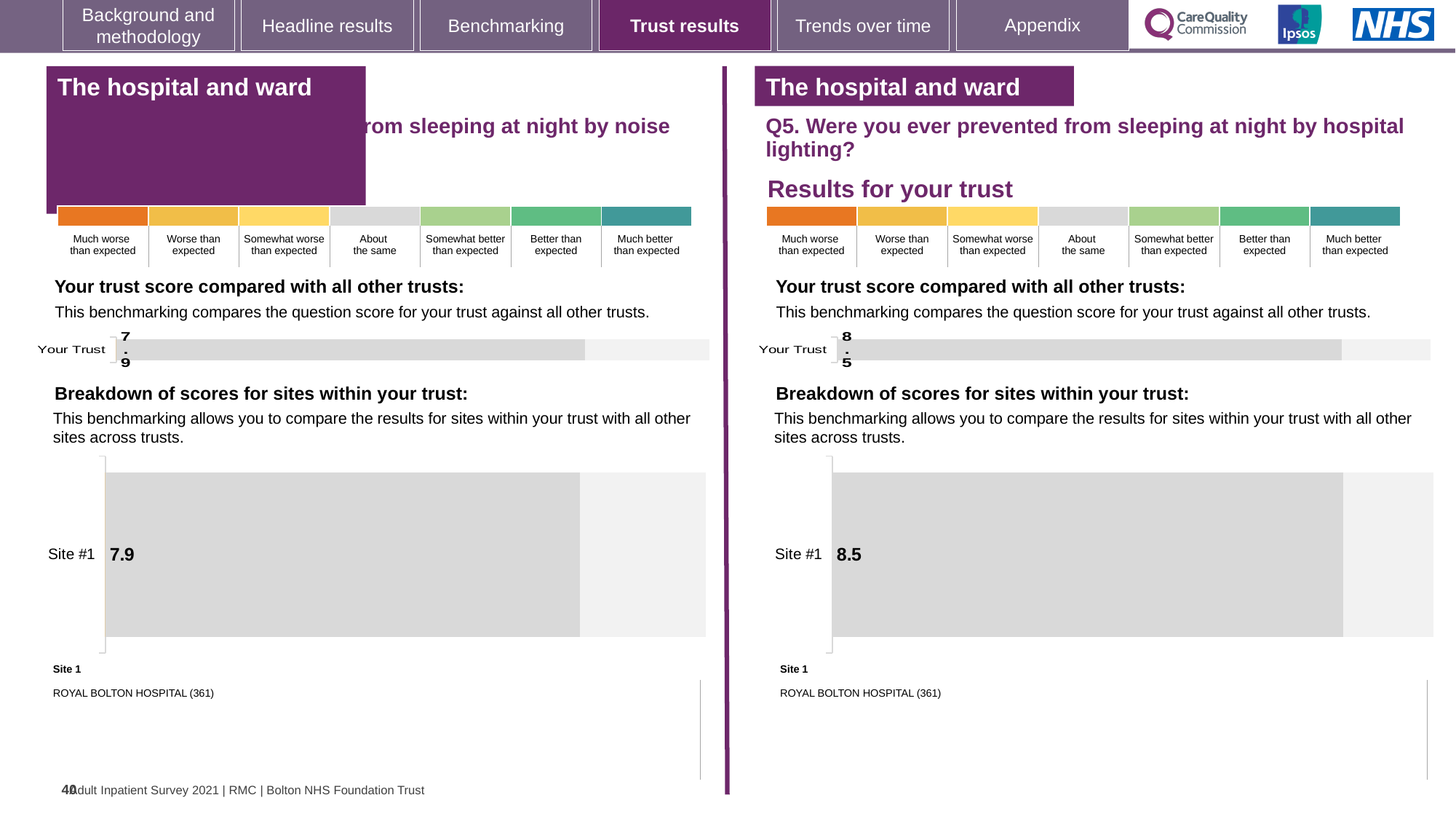
On the right-hand breakdown chart (Q5, hospital lighting), what is the score for Site #1? 8.5 Which Site #1 score is larger: the one on the left-hand chart (noise) or the one on the right-hand chart (hospital lighting)? The right-hand chart (hospital lighting), 8.5 What kind of chart is used to show the breakdown of scores for sites within your trust? Bar chart According to the slide, which hospital is Site 1? ROYAL BOLTON HOSPITAL (361) On the left-hand chart (sleeping at night by noise), what is the score shown for Your Trust? 7.9 How many sites are shown in the right-hand breakdown chart? 1 What is the difference between the Site #1 score on the right-hand chart (8.5) and the Site #1 score on the left-hand chart (7.9)? 0.6 On the right-hand chart (Q5, hospital lighting), what is the score shown for Your Trust? 8.5 How many rating categories are shown in the colour scale above each chart, from 'Much worse than expected' to 'Much better than expected'? 7 How many sites are shown in the left-hand breakdown chart? 1 On the left-hand breakdown chart (sleeping at night by noise), what is the score for Site #1? 7.9